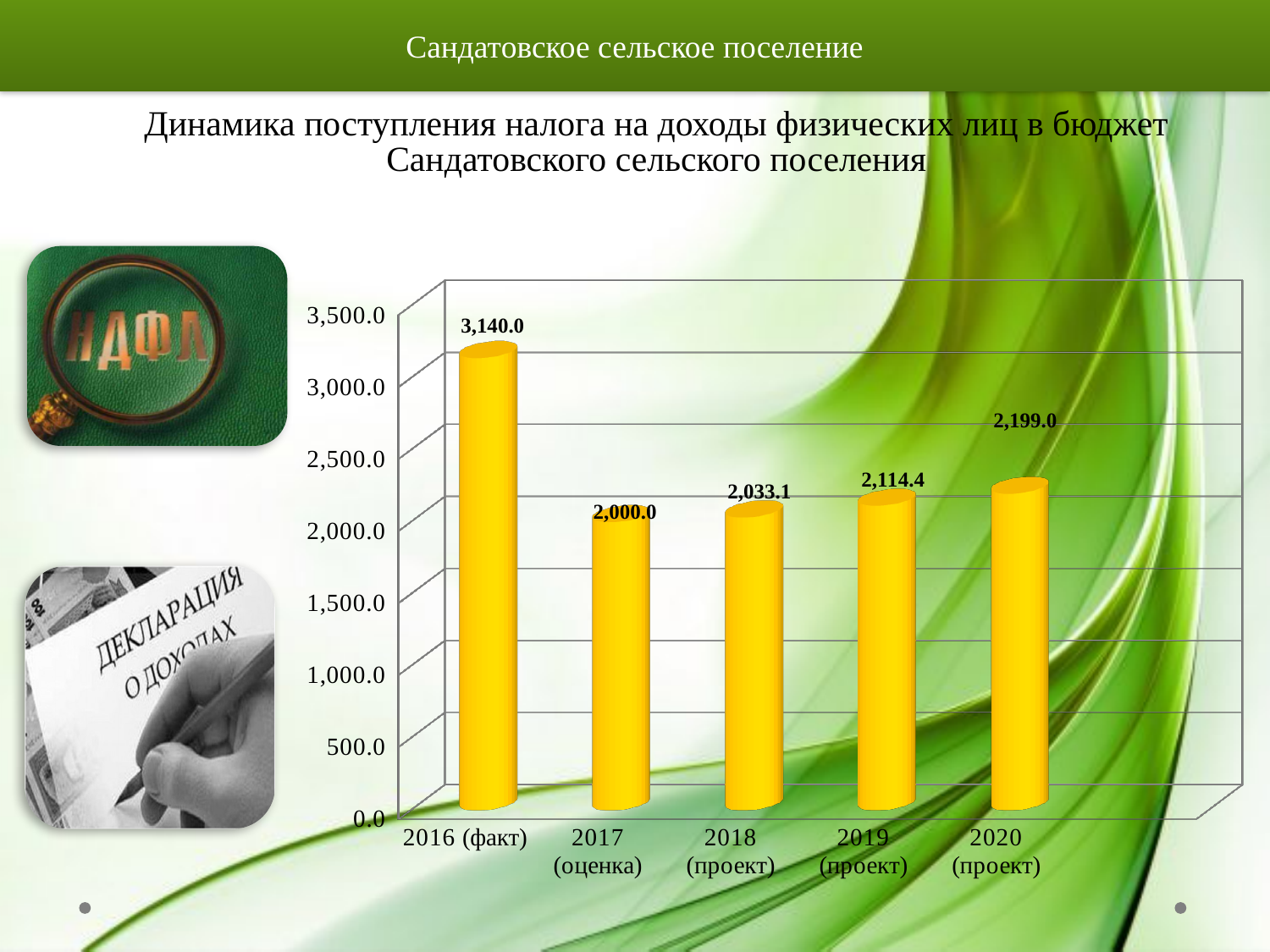
What is the value for 2018 (проект)? 2,033.1 What is the value for 2016 (факт)? 3,140.0 How many categories are shown on the x axis? 5 What is the value for 2020 (проект)? 2,199.0 What kind of chart is shown on the slide? bar chart Which category has the highest value? 2016 (факт) Which category has the lowest value? 2017 (оценка) What is the difference between the values for 2020 (проект) and 2019 (проект)? 84.6 What is the difference between the values for 2016 (факт) and 2017 (оценка)? 1,140.0 Which is larger, the value for 2019 (проект) or the value for 2018 (проект)? 2019 (проект) Is the value for 2016 (факт) greater or less than 3,000.0? greater From 2017 (оценка) to 2020 (проект), do the values rise or fall? rise